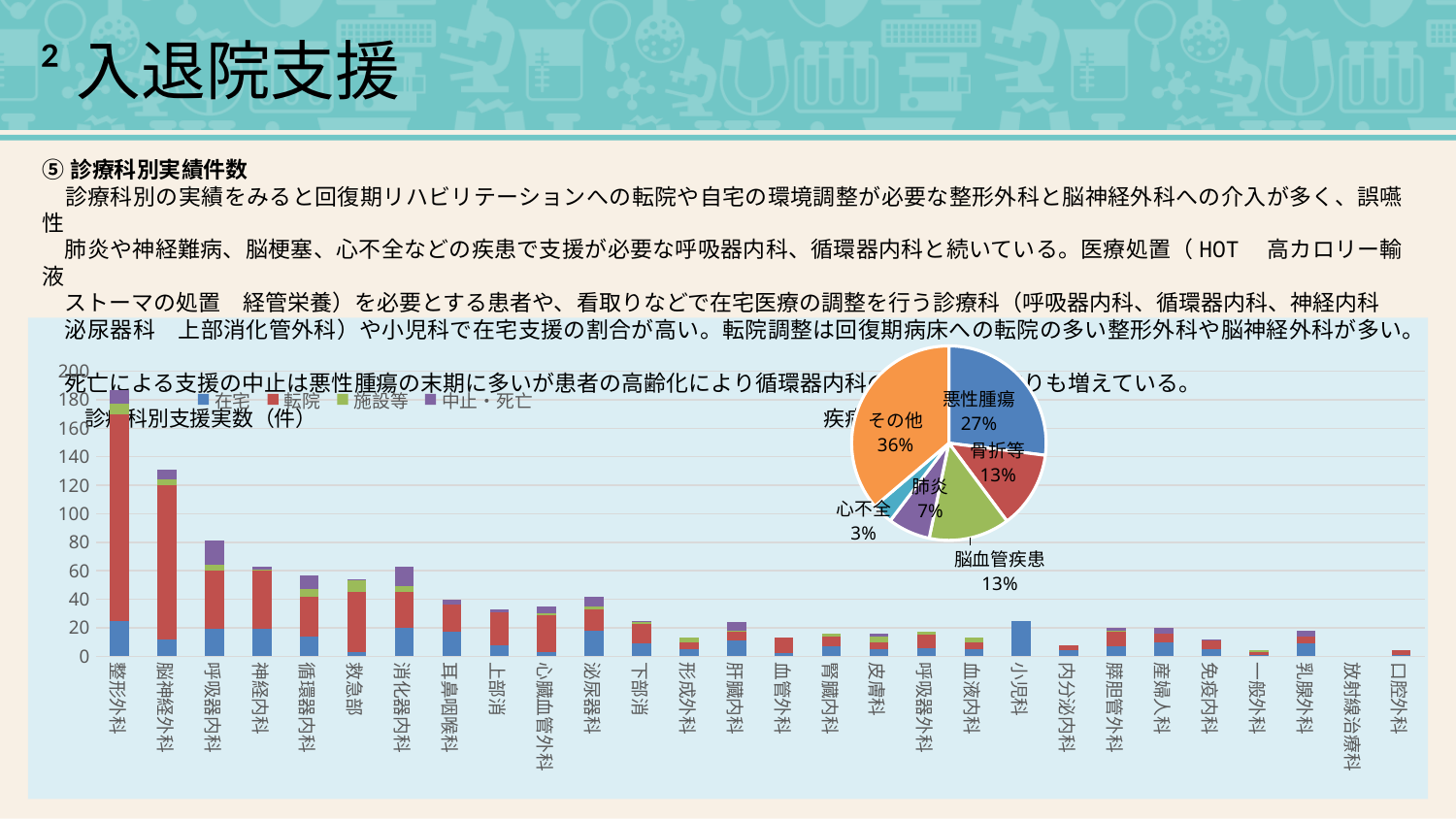
In the pie chart on the right, which slice is the largest? その他 What kind of chart is the chart titled 診療科別支援実数（件）? bar chart In the chart titled 診療科別支援実数（件）, how many series does the legend list? 4 In the chart titled 診療科別支援実数（件）, how many departments are shown on the x axis? 28 In the chart titled 診療科別支援実数（件）, which department has the highest total bar? 整形外科 In the chart titled 診療科別支援実数（件）, which has a larger total bar, 脳神経外科 or 神経内科? 脳神経外科 In the chart titled 診療科別支援実数（件）, is the total value for 整形外科 greater or less than 160? greater In the chart titled 診療科別支援実数（件）, is the total value for 呼吸器内科 greater or less than 100? less In the chart titled 診療科別支援実数（件）, what is the last legend entry? 中止・死亡 In the pie chart on the right, which slice is the smallest? 心不全 In the pie chart on the right, what share does 悪性腫瘍 have? 27% In the pie chart on the right, what is the difference in percentage points between 悪性腫瘍 and 骨折等? 14